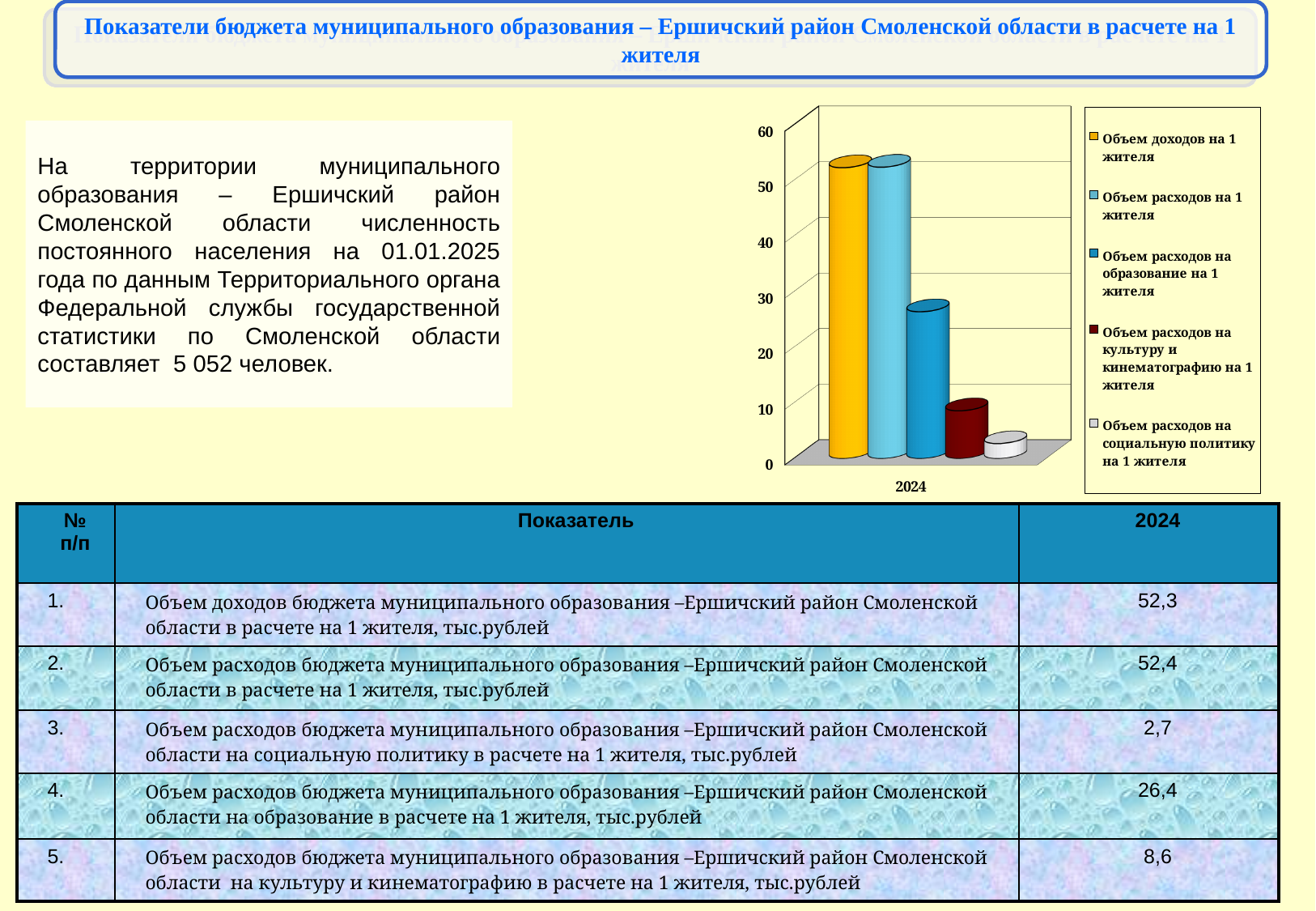
Which is larger in the chart: the bar for 'Объем расходов на образование на 1 жителя' or the bar for 'Объем расходов на культуру и кинематографию на 1 жителя'? Объем расходов на образование на 1 жителя Is the bar for 'Объем доходов на 1 жителя' greater or less than 50? greater Which year is shown on the x axis of the chart? 2024 According to the slide, what is the value of 'Объем расходов на образование на 1 жителя' for 2024? 26,4 Which series has the lowest bar in the chart? Объем расходов на социальную политику на 1 жителя What colour is the bar for 'Объем доходов на 1 жителя' in the chart? yellow According to the slide, what is the value of 'Объем расходов на социальную политику на 1 жителя' for 2024? 2,7 How many categories are shown on the x axis of the chart? 1 How many series does the chart legend list? 5 Is the bar for 'Объем расходов на образование на 1 жителя' greater or less than 20? greater What kind of chart is shown on the slide? bar chart